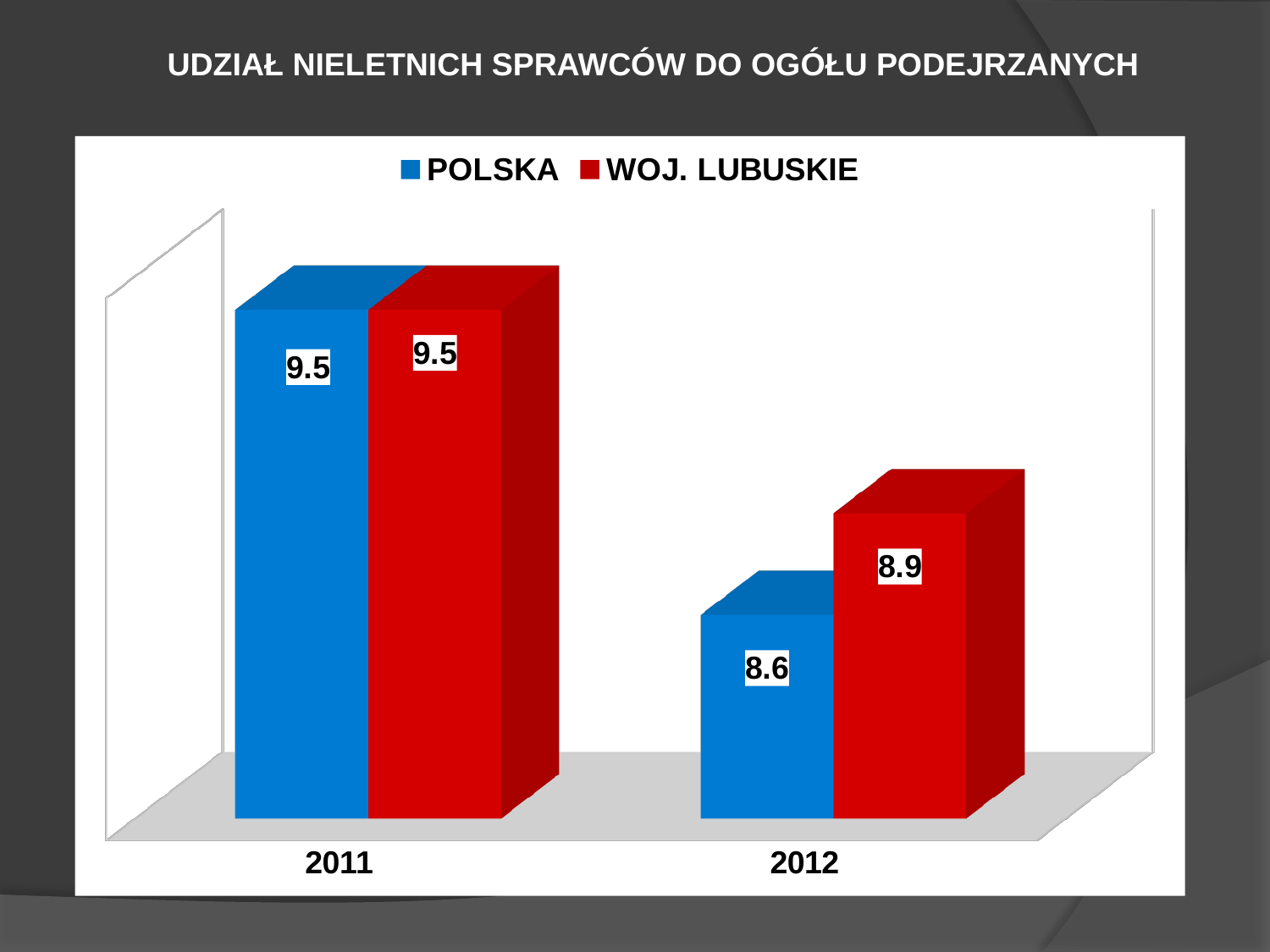
How many years are shown on the x axis? 2 In 2012, which is larger: POLSKA or WOJ. LUBUSKIE? WOJ. LUBUSKIE How many series does the legend list? 2 What is the value for WOJ. LUBUSKIE in 2012? 8.9 What kind of chart is shown on the slide? bar chart What is the value for WOJ. LUBUSKIE in 2011? 9.5 Which year has the lowest value for POLSKA? 2012 What is the value for POLSKA in 2011? 9.5 Do the WOJ. LUBUSKIE values rise or fall from 2011 to 2012? fall What is the difference between the WOJ. LUBUSKIE and POLSKA values in 2012? 0.3 What is the difference between the POLSKA values for 2011 and 2012? 0.9 What is the value for POLSKA in 2012? 8.6